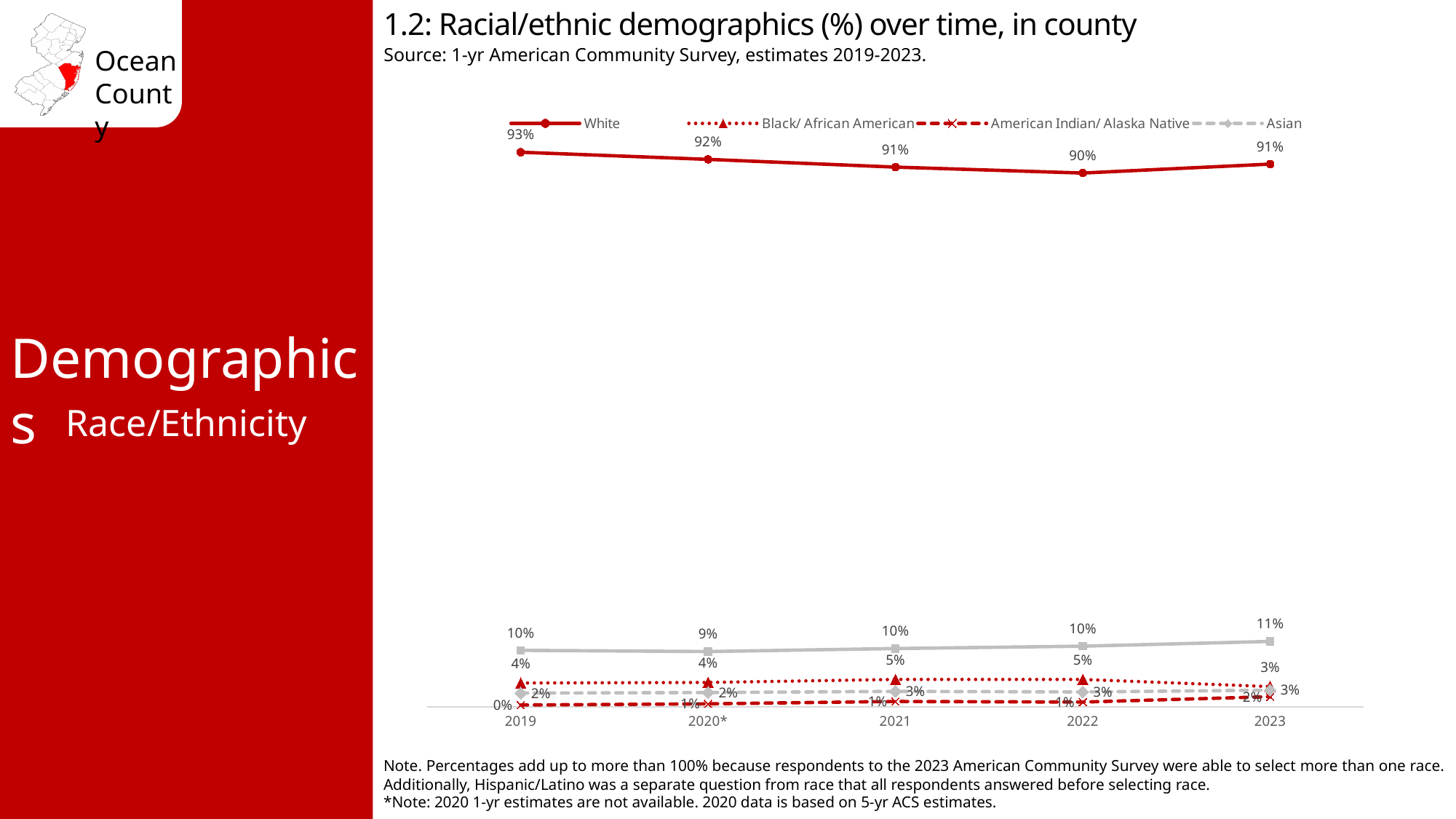
What is the value for White in 2022? 90% What is the value for Black/ African American in 2023? 3% How many years are shown on the x axis? 5 What is the value for White in 2019? 93% What is the value for Asian in 2023? 3% Does the White series rise or fall from 2019 to 2022? Fall Which year has the larger White value, 2019 or 2022? 2019 What kind of chart is shown on the slide? Line chart What is the value for American Indian/ Alaska Native in 2019? 0% What is the difference between the White value in 2019 and in 2023? 2 percentage points What is the value for Black/ African American in 2021? 5% In which year is the White series at its lowest value? 2022